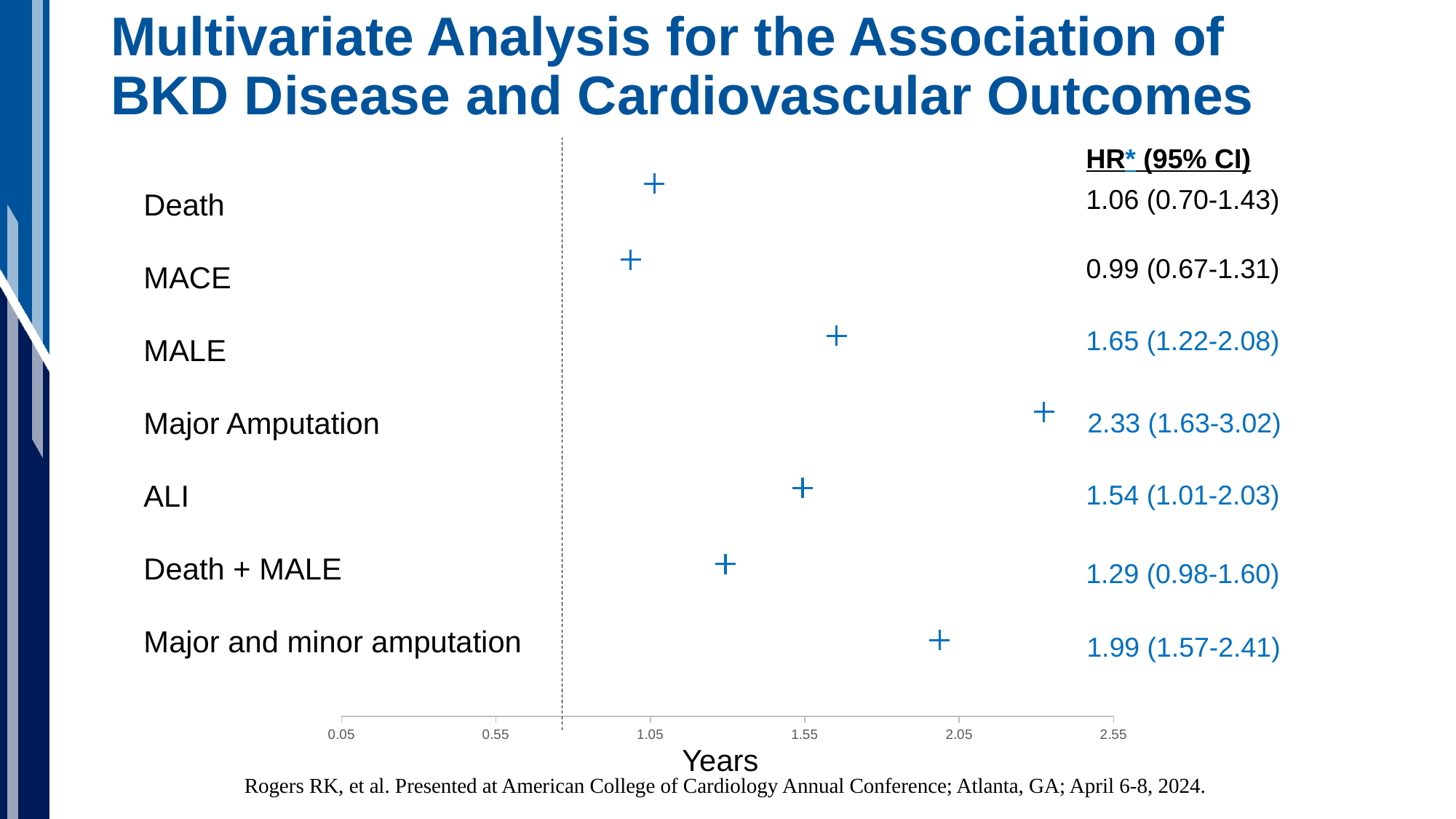
What is the 95% CI printed for MALE? 1.22-2.08 What is the difference between the HR for Major Amputation and the HR for MALE? 0.68 How many outcomes are plotted on the chart? 7 What is the x-axis title of the chart? Years What is the HR value printed for MACE? 0.99 What is the HR printed for Major and minor amputation? 1.99 Which has a larger HR, MALE or ALI? MALE What is the header of the column of values to the right of the chart? HR* (95% CI) Which outcome has the highest HR? Major Amputation What is the hazard ratio (HR) shown for Major Amputation? 2.33 Which outcome has the lowest HR? MACE Is the plotted value for Major Amputation greater or less than 2.05? greater